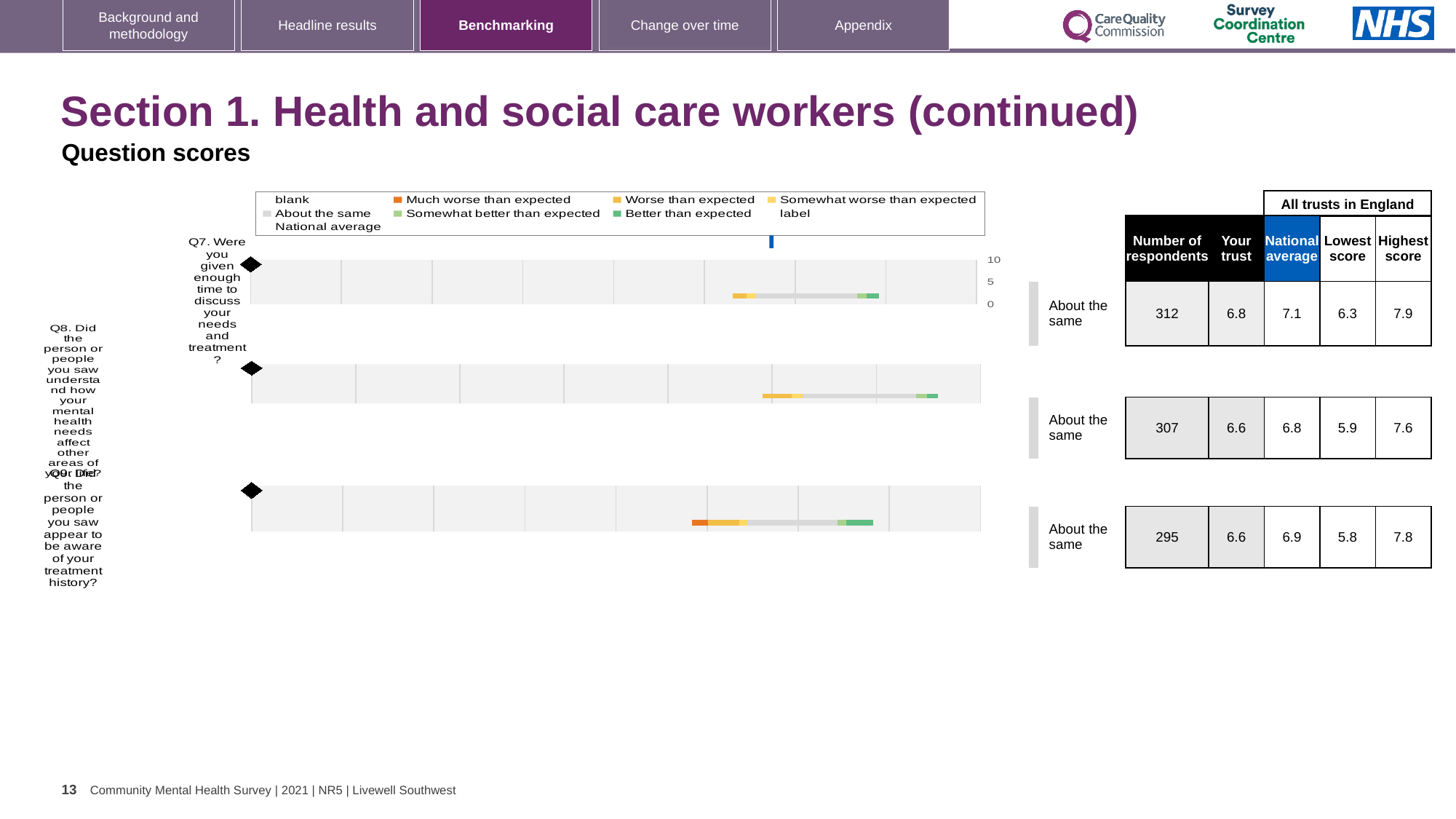
Which has the higher 'Your trust' score, Q7 or Q8? Q7 What benchmarking category is shown next to each of the three question bars? About the same What colour does the legend use for 'Much worse than expected'? Orange How many questions (Q7, Q8, Q9) have a benchmarking bar on the slide? 3 For Q8, how many respondents are listed? 307 Which question has the highest 'Highest score' among all trusts in England? Q7 (7.9) For Q7 (Were you given enough time to discuss your needs and treatment?), what is the number of respondents? 312 What kind of chart is used to show the question scores for Q7, Q8 and Q9? Bar chart For Q7, what is the difference between the national average and the 'Your trust' score? 0.3 For Q8 (Did the person or people you saw understand how your mental health needs affect other areas of your life?), what is the 'Your trust' score? 6.6 Which question has the lowest 'Lowest score' among all trusts in England? Q9 (5.8) For Q9 (Did the person or people you saw appear to be aware of your treatment history?), what is the national average score? 6.9